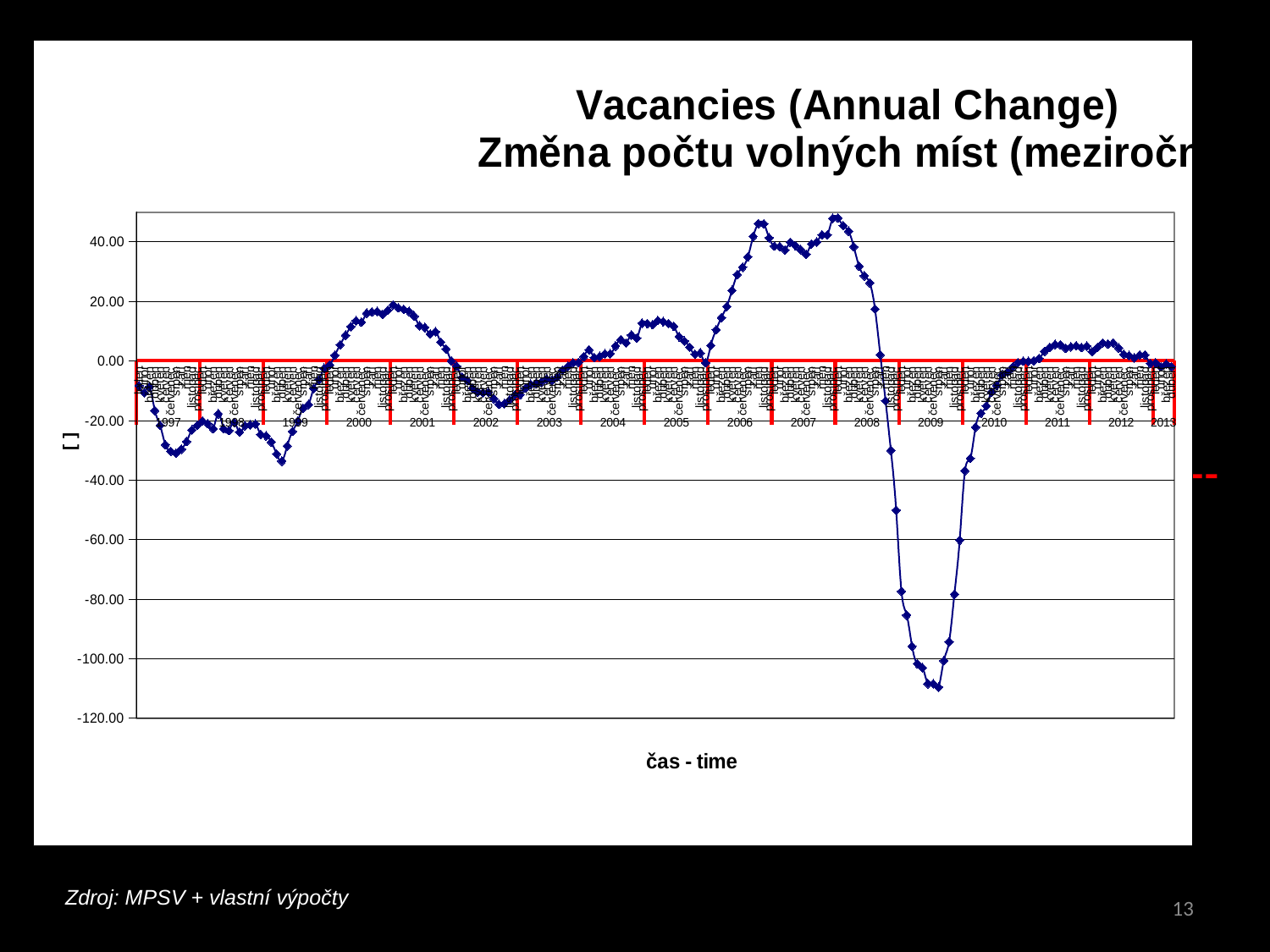
What is the label of the x axis? čas - time What kind of chart is shown on the slide? line chart How many year labels are shown along the x axis, from 1997 to 2013? 17 Does the line rise or fall between 2009 and 2010? rise Is the peak value of the line in 2000 greater or less than 0? greater Does the line rise or fall between 2008 and 2009? fall Is the lowest value of the line, reached in 2009, greater or less than -100? less Is the value of the line at the start of 1997 greater or less than 0? less What is the English title of the chart? Vacancies (Annual Change) What is the lowest tick value shown on the y axis? -120.00 In which year does the line reach its lowest value? 2009